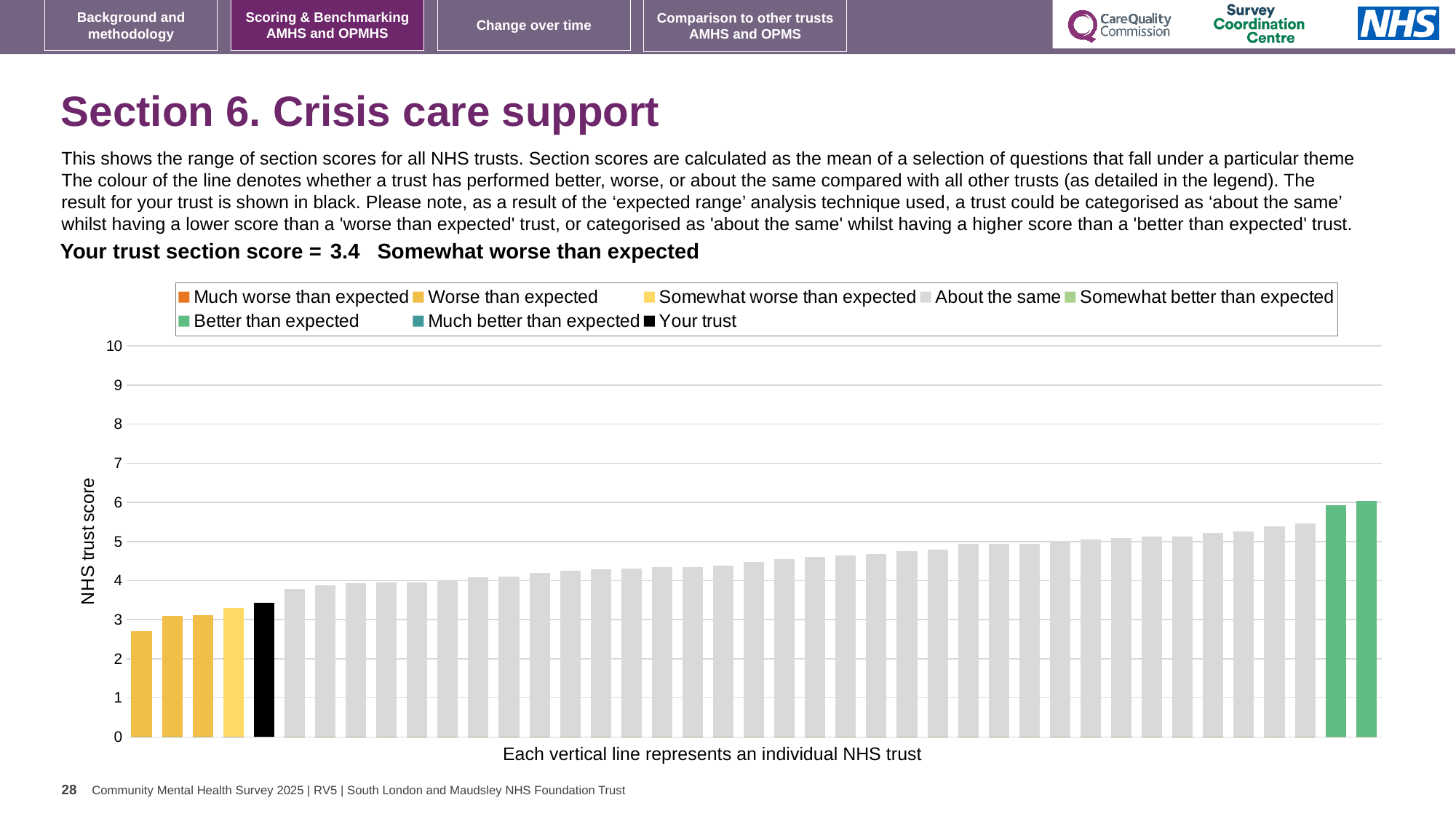
How many green bars are shown at the right end of the chart? 2 What is the label on the vertical axis of the chart? NHS trust score Is the value for your trust's bar greater or less than 4? less What kind of chart is shown on the slide? Bar chart Which is larger: the leftmost bar or the black bar for your trust? The black bar for your trust What colour is the bar representing your trust? Black Do the bar values rise or fall from left to right along the x axis? Rise Is the value of the leftmost bar greater or less than 3? less Which category is your trust placed in for this section? Somewhat worse than expected Is the value of the tallest bar greater or less than 5? greater What is the section score for your trust shown on the slide? 3.4 How many entries does the chart legend list? 8